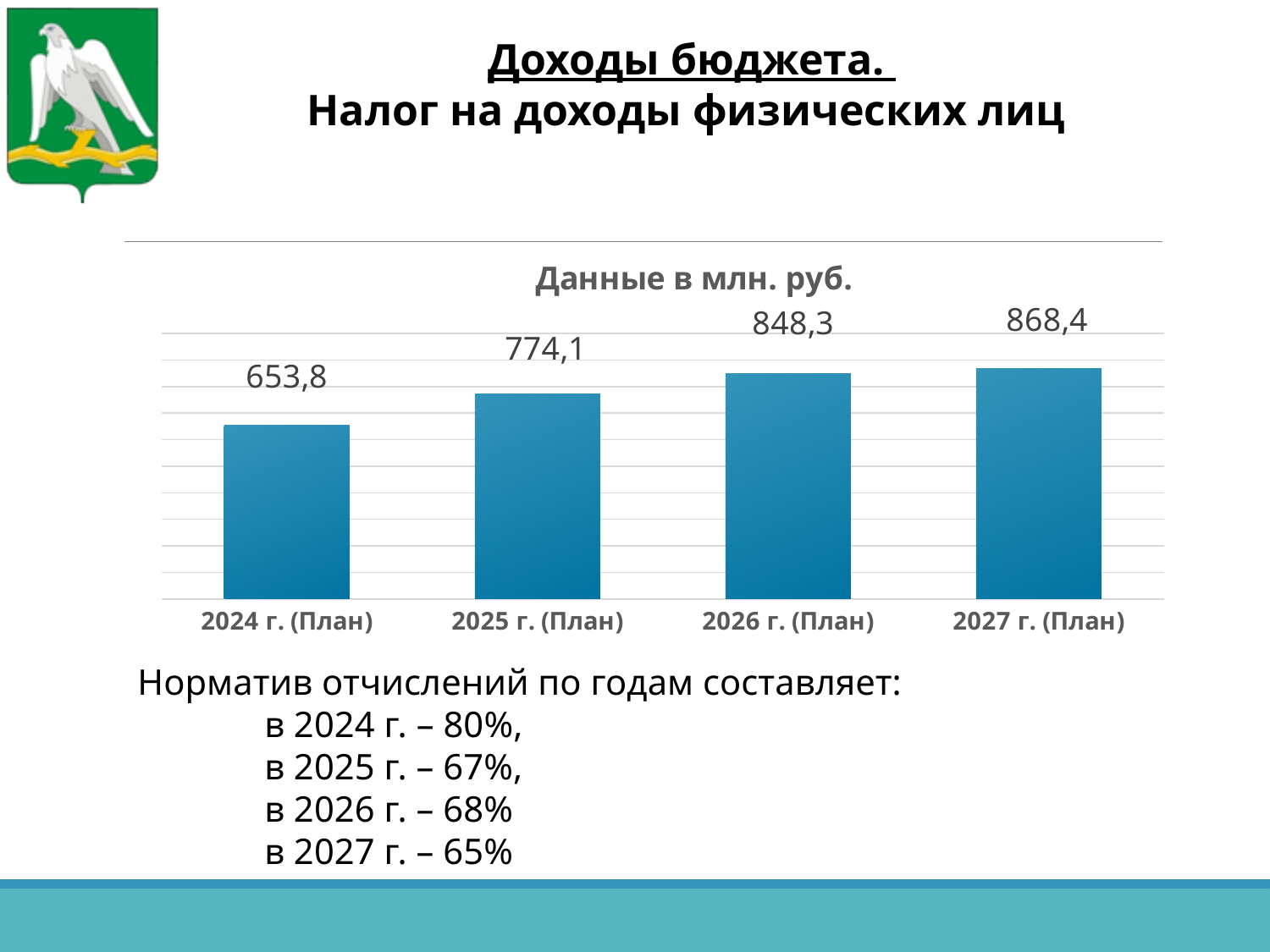
Which year has the lowest value? 2024 г. (План) What is the value for 2024 г. (План)? 653,8 Which year has the highest value? 2027 г. (План) What is the value for 2025 г. (План)? 774,1 What is the value for 2027 г. (План)? 868,4 What is the difference between the values for 2027 г. (План) and 2026 г. (План)? 20,1 Do the values rise or fall from 2024 to 2027? Rise What is the difference between the values for 2025 г. (План) and 2024 г. (План)? 120,3 How many bars are shown in the chart? 4 What is the value for 2026 г. (План)? 848,3 Which is larger, the value for 2026 г. (План) or the value for 2025 г. (План)? 2026 г. (План) What kind of chart is shown on the slide? Bar chart